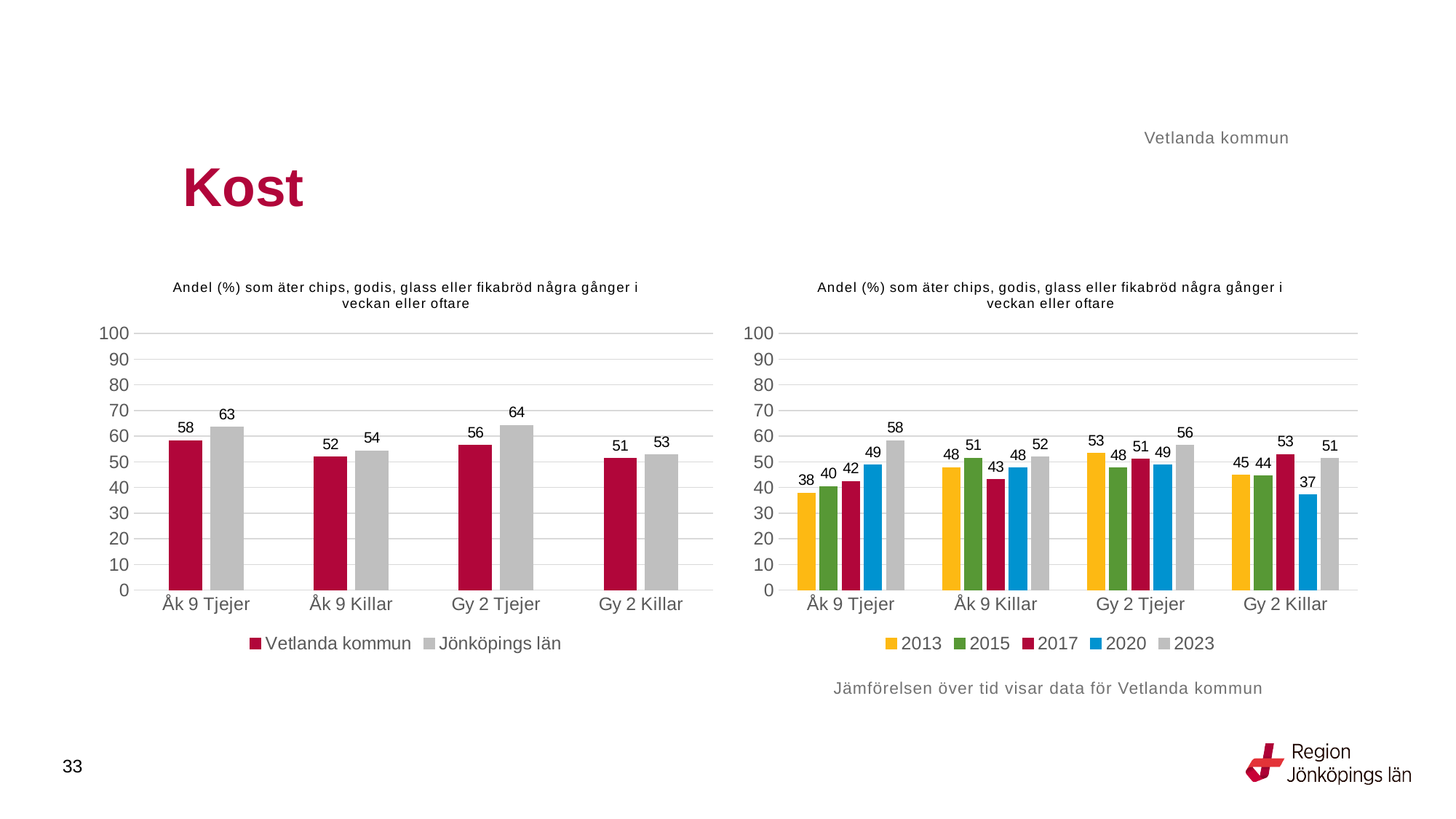
In the left chart, how many series does the legend list? 2 In the right chart, is the value for 2013 for Gy 2 Tjejer larger or smaller than the value for 2015 for Gy 2 Tjejer? larger In the right chart, how many series does the legend list? 5 In the left chart, what is the difference between Jönköpings län and Vetlanda kommun for Gy 2 Tjejer? 8 In the left chart, what is the value for Jönköpings län for Gy 2 Tjejer? 64 In the right chart, what is the value for 2020 for Gy 2 Killar? 37 In the left chart, what is the value for Vetlanda kommun for Åk 9 Killar? 52 In the right chart, which year has the lowest value for Åk 9 Killar? 2017 In the right chart, what is the value for 2023 for Åk 9 Tjejer? 58 What kind of chart is the left chart? bar chart In the left chart, which category has the highest value for Vetlanda kommun? Åk 9 Tjejer In the right chart, do the values for Åk 9 Tjejer rise or fall from 2013 to 2023? rise